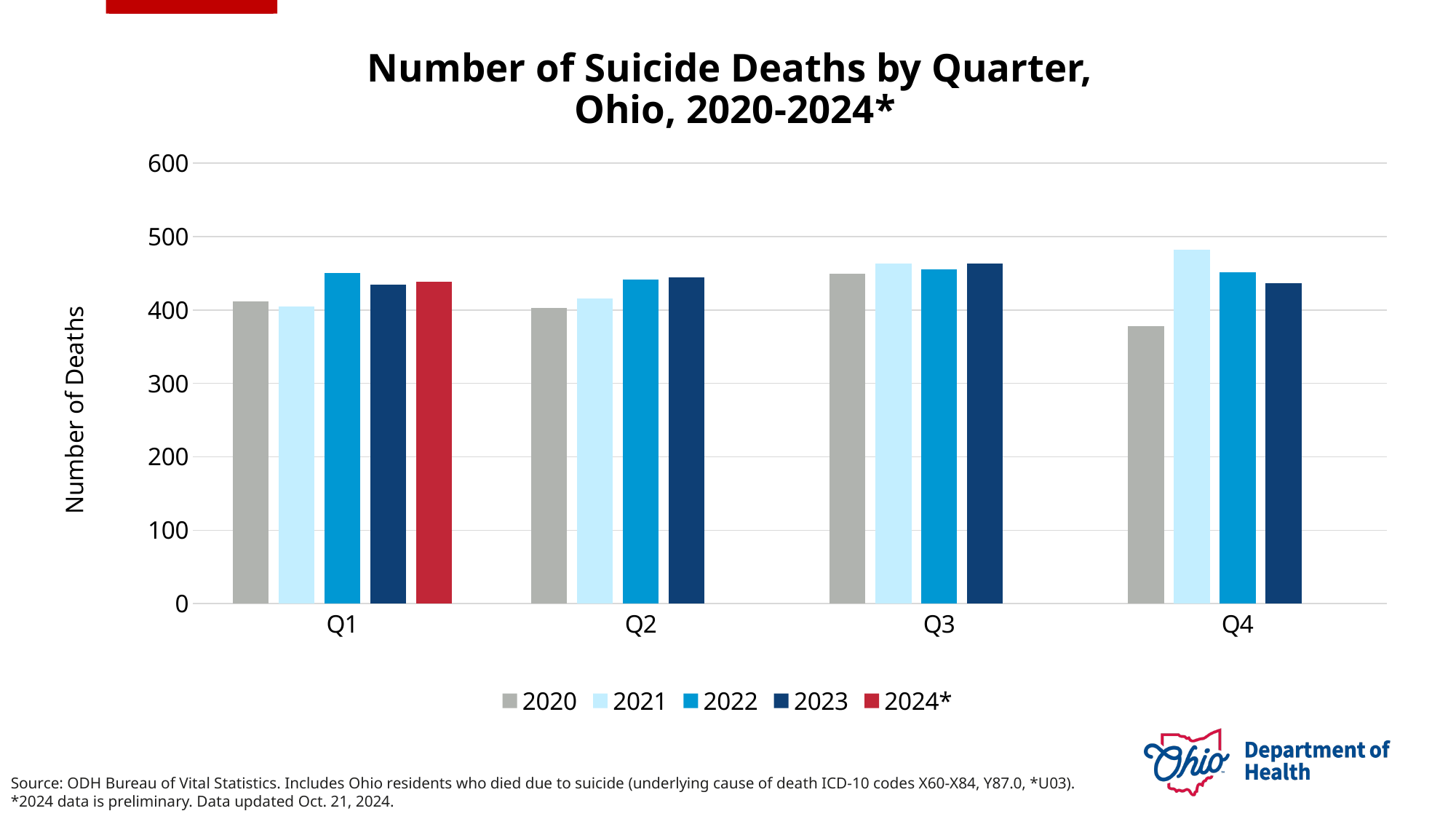
In Q1, which is larger: the value for 2021 or the value for 2022? 2022 In Q4, which year has the highest number of deaths? 2021 Is the value for 2021 in Q4 greater or less than 500? less Is the value for 2020 in Q4 greater or less than 400? less How many series does the legend list? 5 How many quarters are shown on the x axis? 4 Which series is shown in red? 2024* Is the value for 2022 in Q1 greater or less than 400? greater What kind of chart is shown on the slide? bar chart In Q4, which year has the lowest number of deaths? 2020